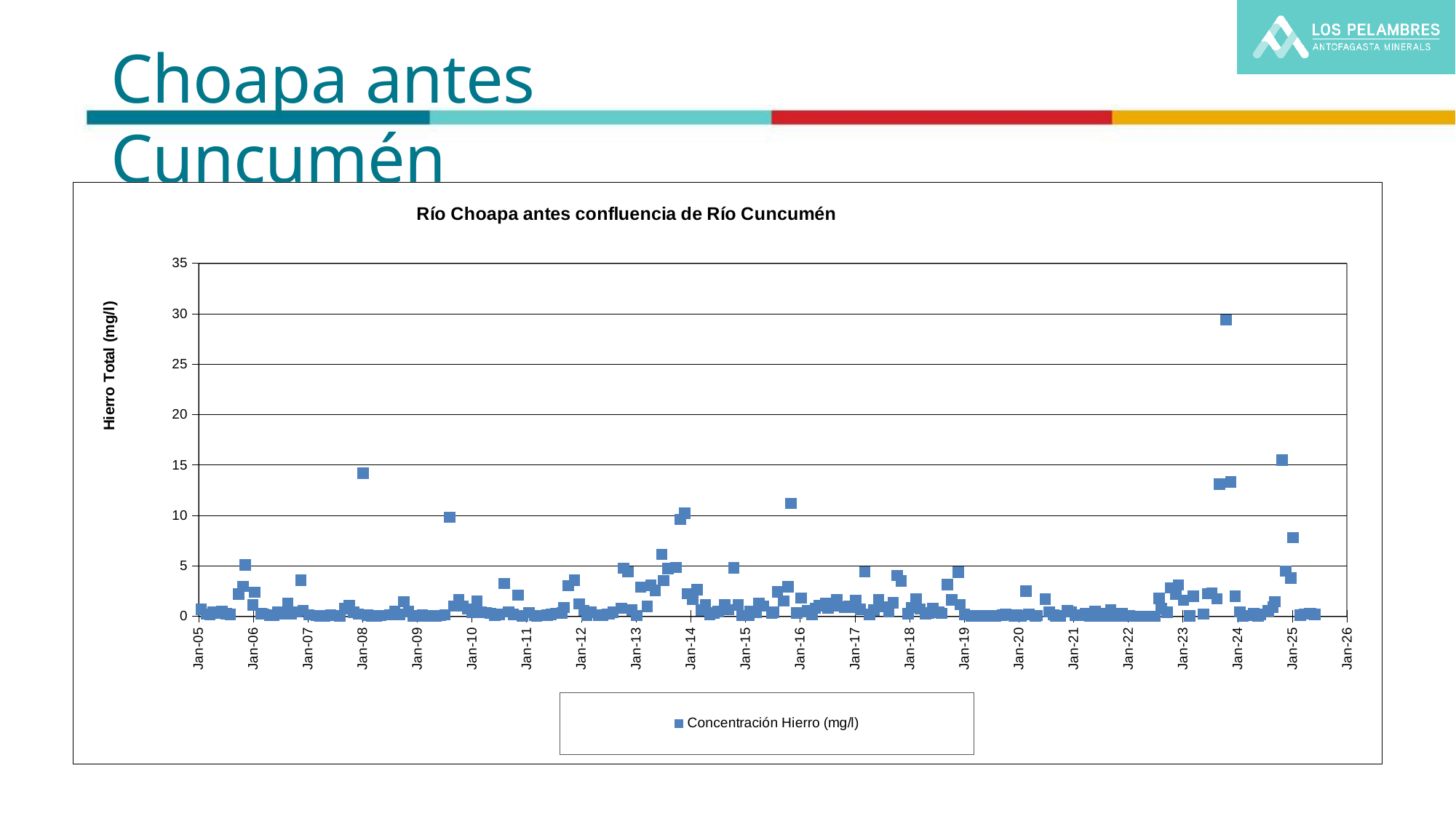
Is the highest plotted value greater or less than 30? less What is the name of the series shown in the legend? Concentración Hierro (mg/l) How many series does the legend list? 1 What is the maximum value shown on the y axis? 35 Is the peak value plotted just before Jan-08 greater or less than 15? less How many year labels are shown along the x axis? 22 Is the peak value plotted just before Jan-08 greater or less than 10? greater What is the title of the chart? Río Choapa antes confluencia de Río Cuncumén What kind of chart is shown on the slide? Scatter chart Between which two x-axis labels does the highest point on the chart fall? Jan-23 and Jan-24